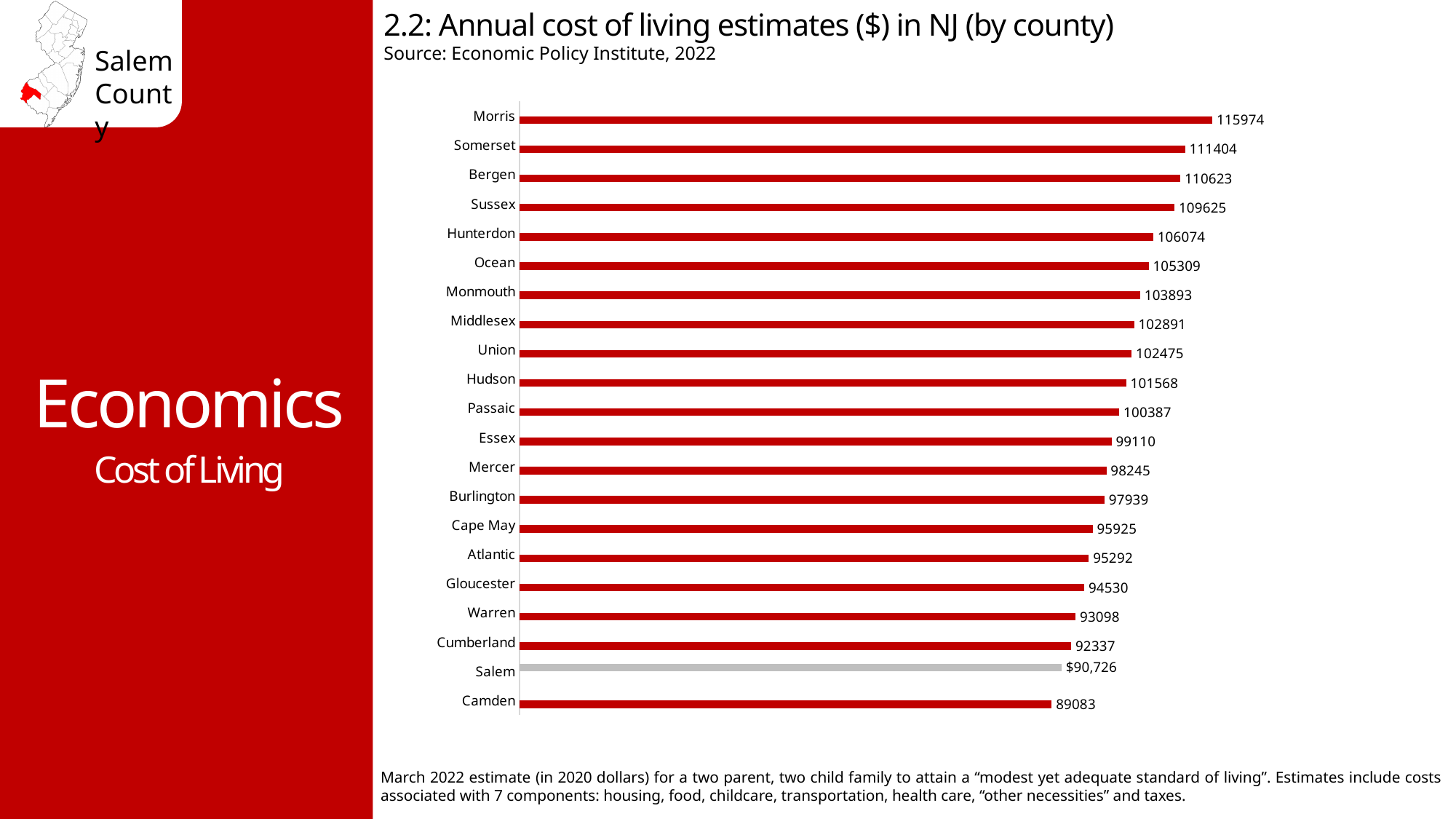
What is the difference between the cost of living estimates for Cumberland and Salem counties? 1611 Which county has the highest annual cost of living estimate? Morris Which county's bar is shown in grey instead of red? Salem What type of chart is used to show the cost of living estimates? Bar chart Which county has the lowest annual cost of living estimate? Camden How many counties are shown in the chart? 21 Which county has a higher cost of living estimate, Ocean or Monmouth? Ocean What is the annual cost of living estimate for Morris county? 115974 What is the annual cost of living estimate for Salem county? $90,726 What is the annual cost of living estimate for Hudson county? 101568 What is the difference between the cost of living estimates for Morris and Camden counties? 26891 What is the annual cost of living estimate for Gloucester county? 94530